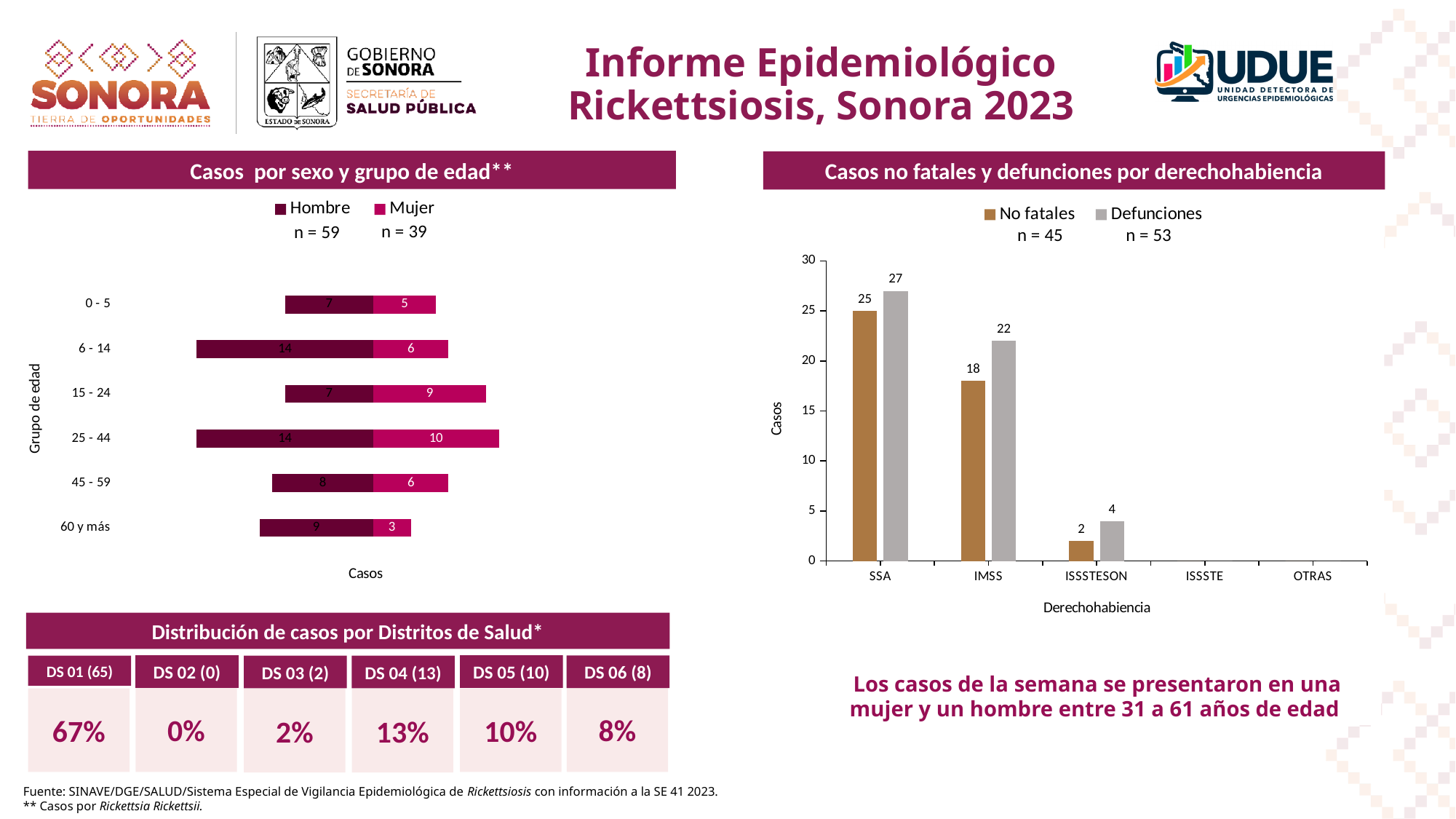
In the chart 'Casos no fatales y defunciones por derechohabiencia', how many series does the legend list? 2 In the chart 'Casos no fatales y defunciones por derechohabiencia', what is the difference between Defunciones and No fatales for SSA? 2 What type of chart is 'Casos no fatales y defunciones por derechohabiencia'? Bar chart In the chart 'Casos por sexo y grupo de edad', which age group has the lowest number of Mujer cases? 60 y más In the chart 'Casos por sexo y grupo de edad', how many Mujer cases are in the 15 - 24 age group? 9 In the chart 'Casos por sexo y grupo de edad', what is the difference between Hombre and Mujer cases in the 60 y más age group? 6 In the chart 'Casos no fatales y defunciones por derechohabiencia', which is larger for ISSSTESON: No fatales or Defunciones? Defunciones In the chart 'Casos por sexo y grupo de edad', how many age groups are shown? 6 In the chart 'Casos no fatales y defunciones por derechohabiencia', how many Defunciones are shown for IMSS? 22 In the chart 'Casos por sexo y grupo de edad', how many Hombre cases are in the 6 - 14 age group? 14 In the chart 'Casos no fatales y defunciones por derechohabiencia', which derechohabiencia has the highest number of No fatales cases? SSA In the chart 'Casos por sexo y grupo de edad', what is the total number of cases in the 25 - 44 age group? 24